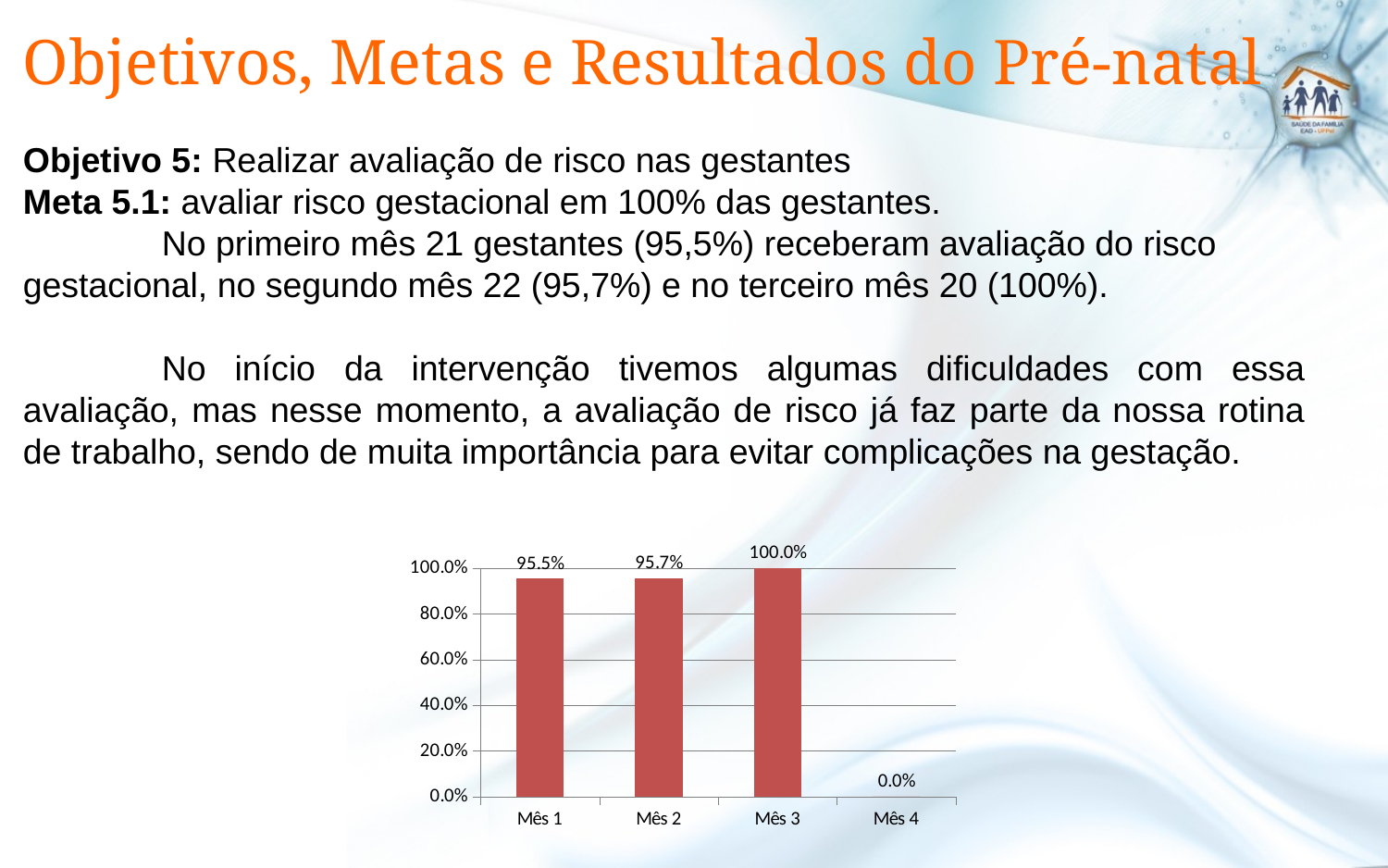
What is the value for Mês 2? 95.7% What is the value for Mês 3? 100.0% Is the value for Mês 2 greater or less than 80.0%? greater What kind of chart is shown on the slide? bar chart What is the difference between the values for Mês 3 and Mês 1? 4.5% Which month has the highest value? Mês 3 How many categories are shown on the x axis? 4 Which is larger, the value for Mês 3 or the value for Mês 2? Mês 3 What is the value for Mês 1? 95.5% Which month has the lowest value? Mês 4 What is the value for Mês 4? 0.0% What colour are the bars in the chart? red